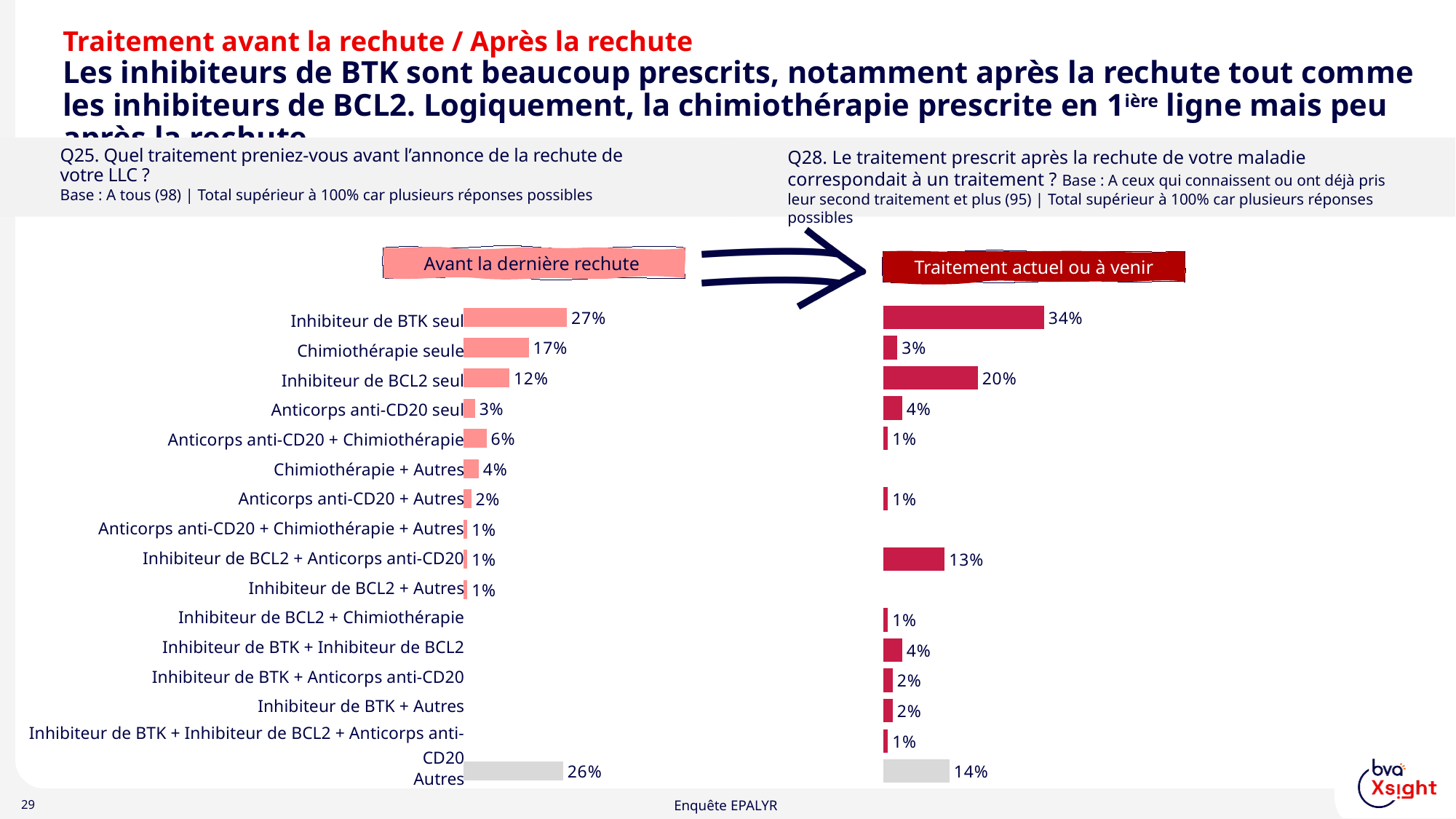
What is the difference between the value for Inhibiteur de BTK seul in the 'Traitement actuel ou à venir' chart and in the 'Avant la dernière rechute' chart? 7% In the 'Traitement actuel ou à venir' chart, which category has the highest value? Inhibiteur de BTK seul In the 'Traitement actuel ou à venir' chart, what is the value for Inhibiteur de BCL2 + Anticorps anti-CD20? 13% In the 'Traitement actuel ou à venir' chart, which is larger: Inhibiteur de BCL2 seul or Chimiothérapie seule? Inhibiteur de BCL2 seul In the 'Traitement actuel ou à venir' chart, what is the value for Inhibiteur de BCL2 seul? 20% In the 'Avant la dernière rechute' chart, what is the value for Anticorps anti-CD20 + Chimiothérapie? 6% Which is larger: Autres in the 'Avant la dernière rechute' chart or Autres in the 'Traitement actuel ou à venir' chart? Avant la dernière rechute In the 'Avant la dernière rechute' chart, which category has the highest value? Inhibiteur de BTK seul What is the difference between Chimiothérapie seule in the 'Avant la dernière rechute' chart and in the 'Traitement actuel ou à venir' chart? 14% In the 'Avant la dernière rechute' chart, what is the value for Chimiothérapie seule? 17% In the 'Avant la dernière rechute' chart, what is the value for Inhibiteur de BTK seul? 27% What type of chart is used on this slide? Bar chart